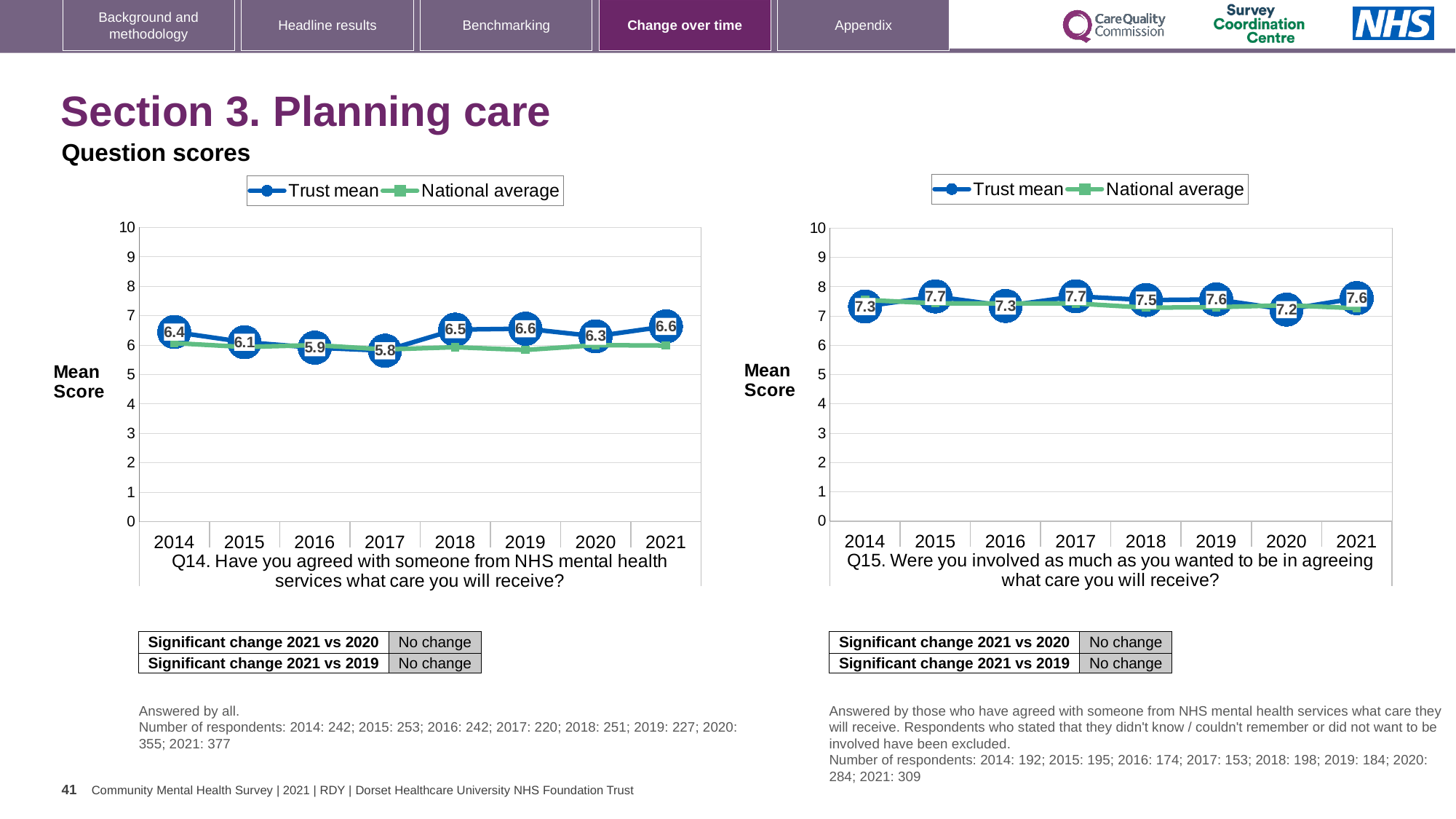
How many years are shown on the x axis of the Q15 chart (right)? 8 On the Q14 chart (left), what is the difference between the Trust mean in 2021 and in 2017? 0.8 On the Q14 chart (left), is the Trust mean higher in 2018 or in 2020? 2018 On the Q14 chart (left), what is the Trust mean for 2017? 5.8 On the Q14 chart (left), which year has the lowest Trust mean? 2017 On the Q15 chart (right), what is the Trust mean for 2020? 7.2 On the Q15 chart (right), what is the Trust mean for 2018? 7.5 On the Q14 chart (left), is the National average for 2014 greater or less than 7? less On the Q14 chart (left), what is the Trust mean for 2021? 6.6 On the Q15 chart (right), what is the difference between the Trust mean in 2015 and in 2020? 0.5 How many series does the legend of the Q14 chart (left) list? 2 On the Q15 chart (right), which year has the lowest Trust mean? 2020